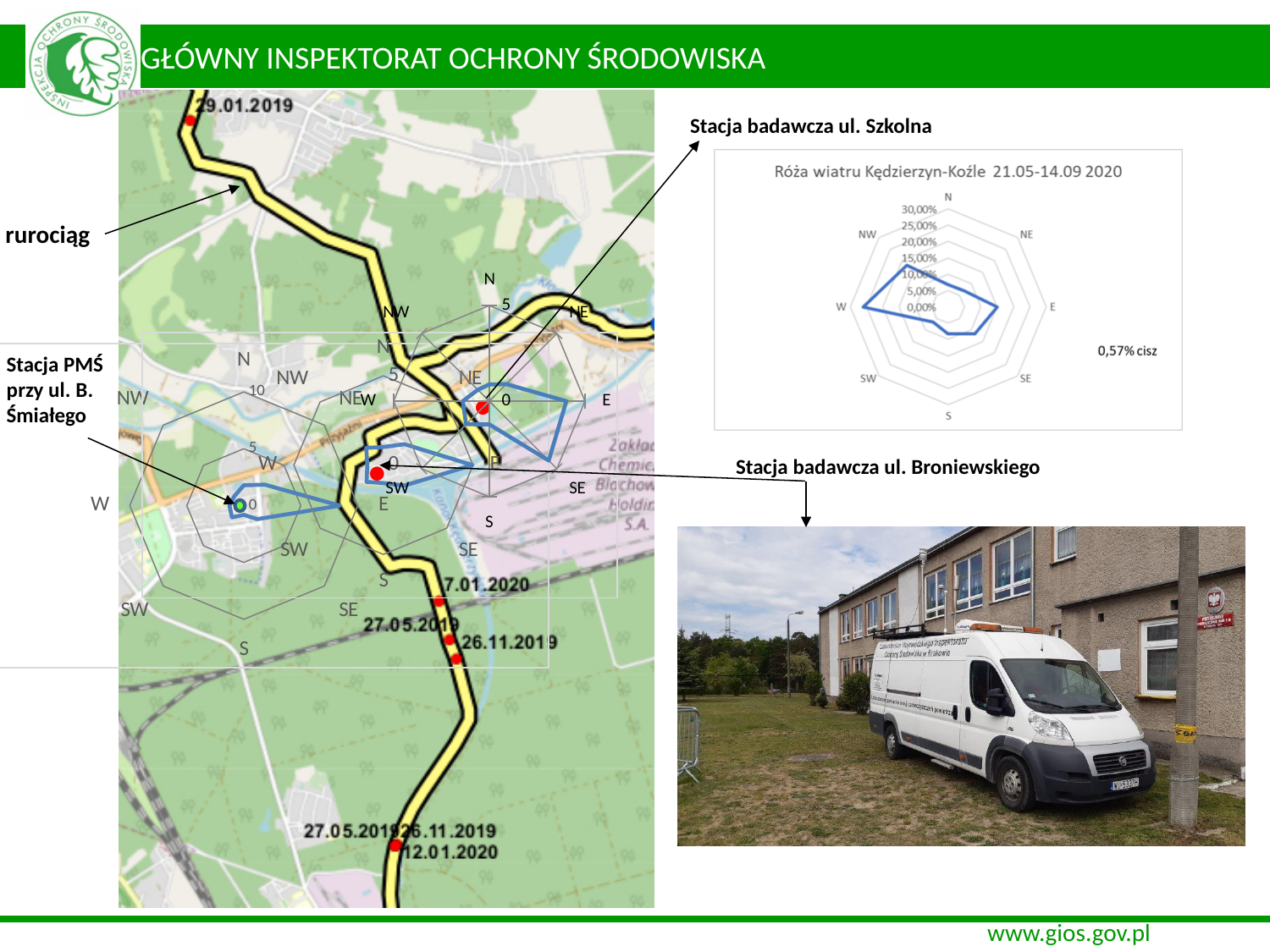
On the wind rose chart, is the value for E greater or less than 15,00%? less How many wind directions are plotted on the wind rose chart? 8 On the wind rose chart, is the value for W greater or less than 20,00%? greater On the wind rose chart, which direction has the larger share, W or N? W On the wind rose chart, is the value for N greater or less than 10,00%? less Which wind direction has the highest share on the wind rose chart? W What is the highest axis tick shown on the wind rose chart? 30,00% What kind of chart is the 'Róża wiatru Kędzierzyn-Koźle' chart? radar chart On the wind rose chart, which direction has the larger share, W or E? W What percentage of calm (cisz) is noted on the wind rose chart? 0,57% What is the title of the wind rose chart on the slide? Róża wiatru Kędzierzyn-Koźle 21.05-14.09 2020